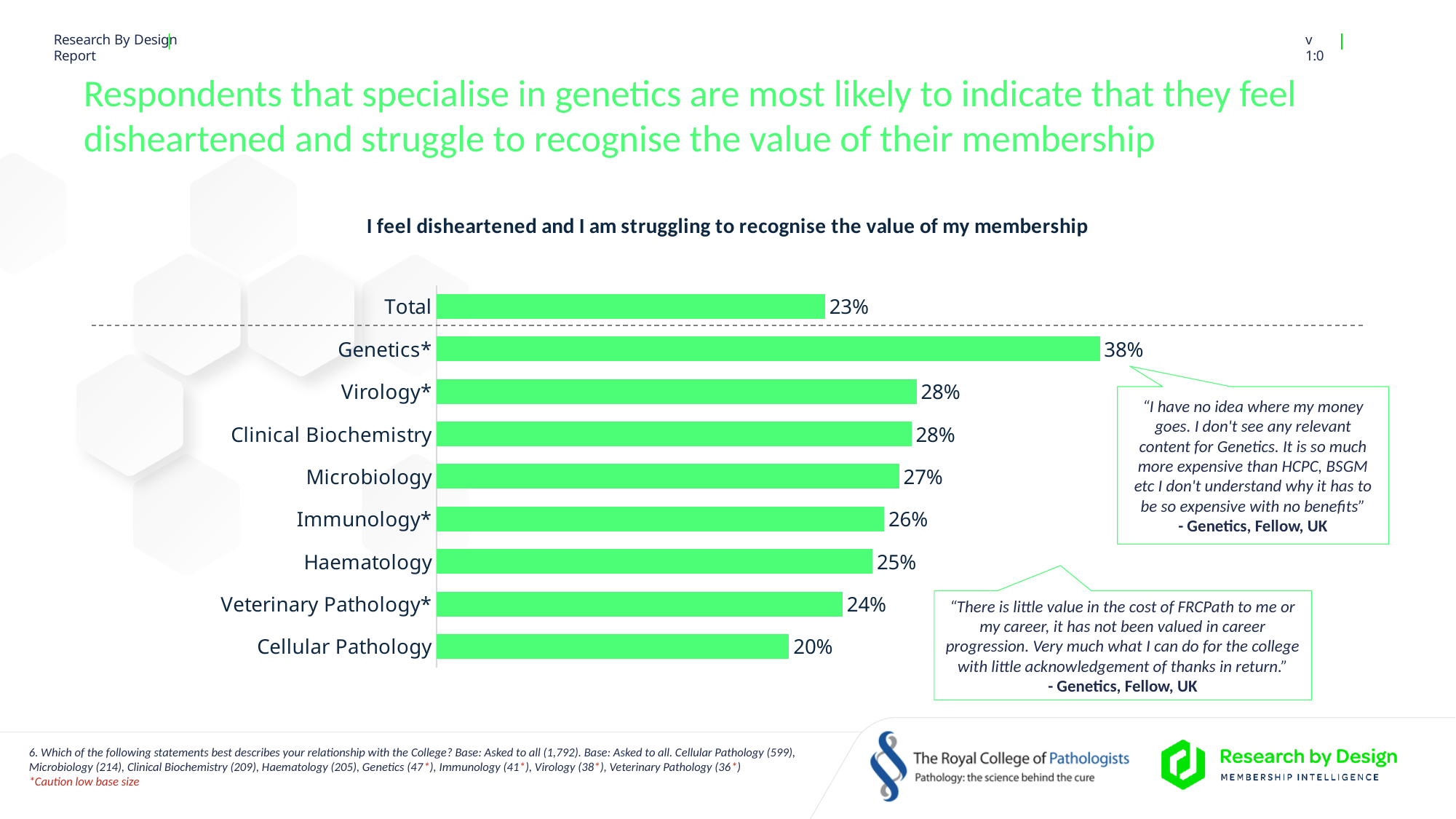
What is the difference between the values for Genetics* and Cellular Pathology? 18% Which category has the highest value? Genetics* What is the title of the chart? I feel disheartened and I am struggling to recognise the value of my membership What is the difference between the values for Genetics* and Total? 15% Which is larger, the value for Haematology or the value for Veterinary Pathology*? Haematology Which category has the lowest value? Cellular Pathology What kind of chart is shown on the slide? Bar chart What is the value for Cellular Pathology? 20% What is the value for Microbiology? 27% What is the value for Genetics*? 38% How many categories are shown in the chart? 9 What is the value for Total? 23%